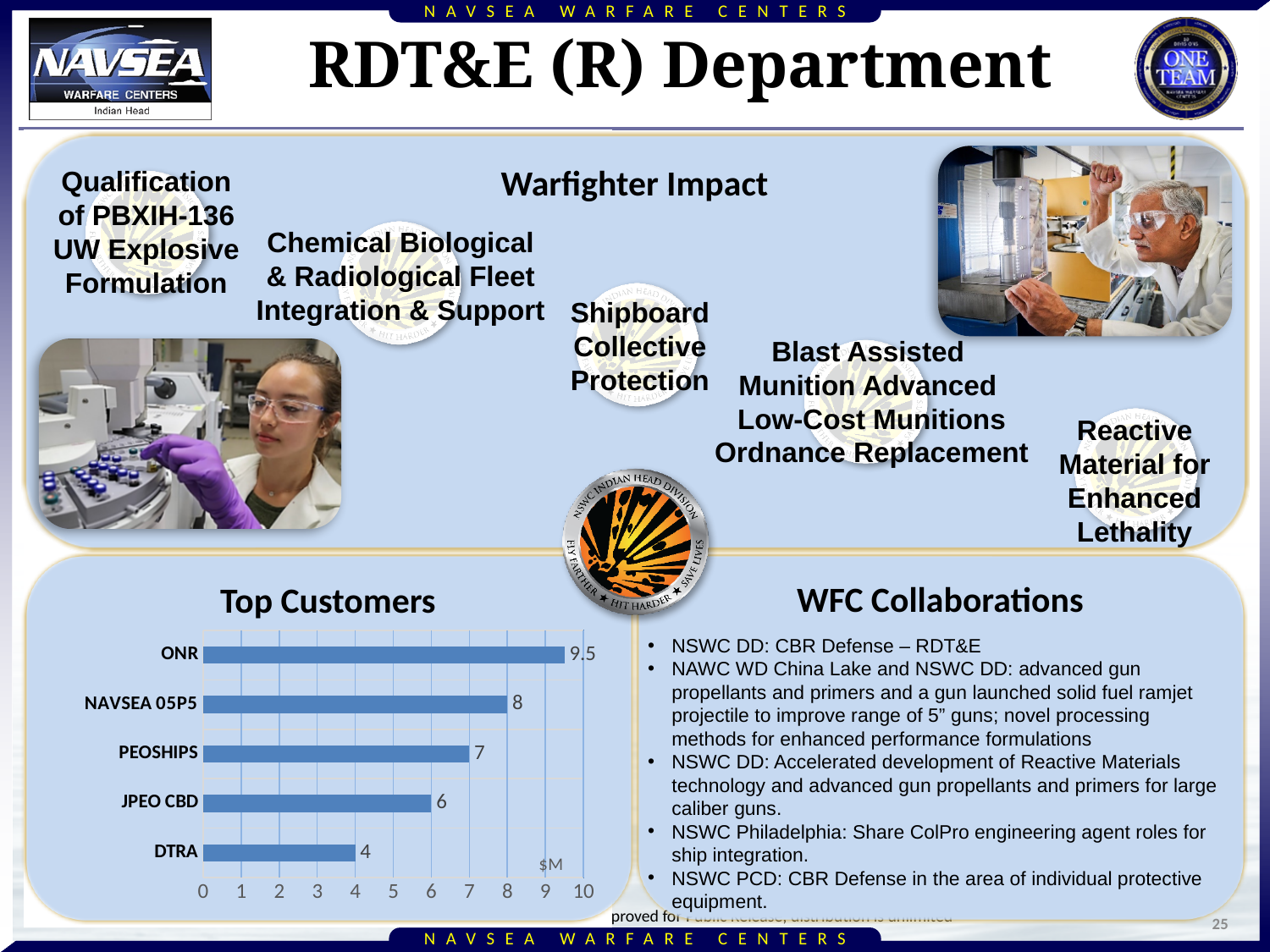
What is the value for NAVSEA 05P5 in the Top Customers chart? 8 What unit is indicated on the axis of the Top Customers chart? $M What kind of chart is the Top Customers chart? bar chart What is the value for ONR in the Top Customers chart? 9.5 What is the title of the chart on the slide? Top Customers Which customer has the lowest value in the Top Customers chart? DTRA What is the value for DTRA in the Top Customers chart? 4 How many customers are shown in the Top Customers chart? 5 What is the difference between the values for ONR and DTRA in the Top Customers chart? 5.5 In the Top Customers chart, which is larger: the value for NAVSEA 05P5 or the value for PEOSHIPS? NAVSEA 05P5 What is the difference between the values for PEOSHIPS and JPEO CBD in the Top Customers chart? 1 Which customer has the highest value in the Top Customers chart? ONR